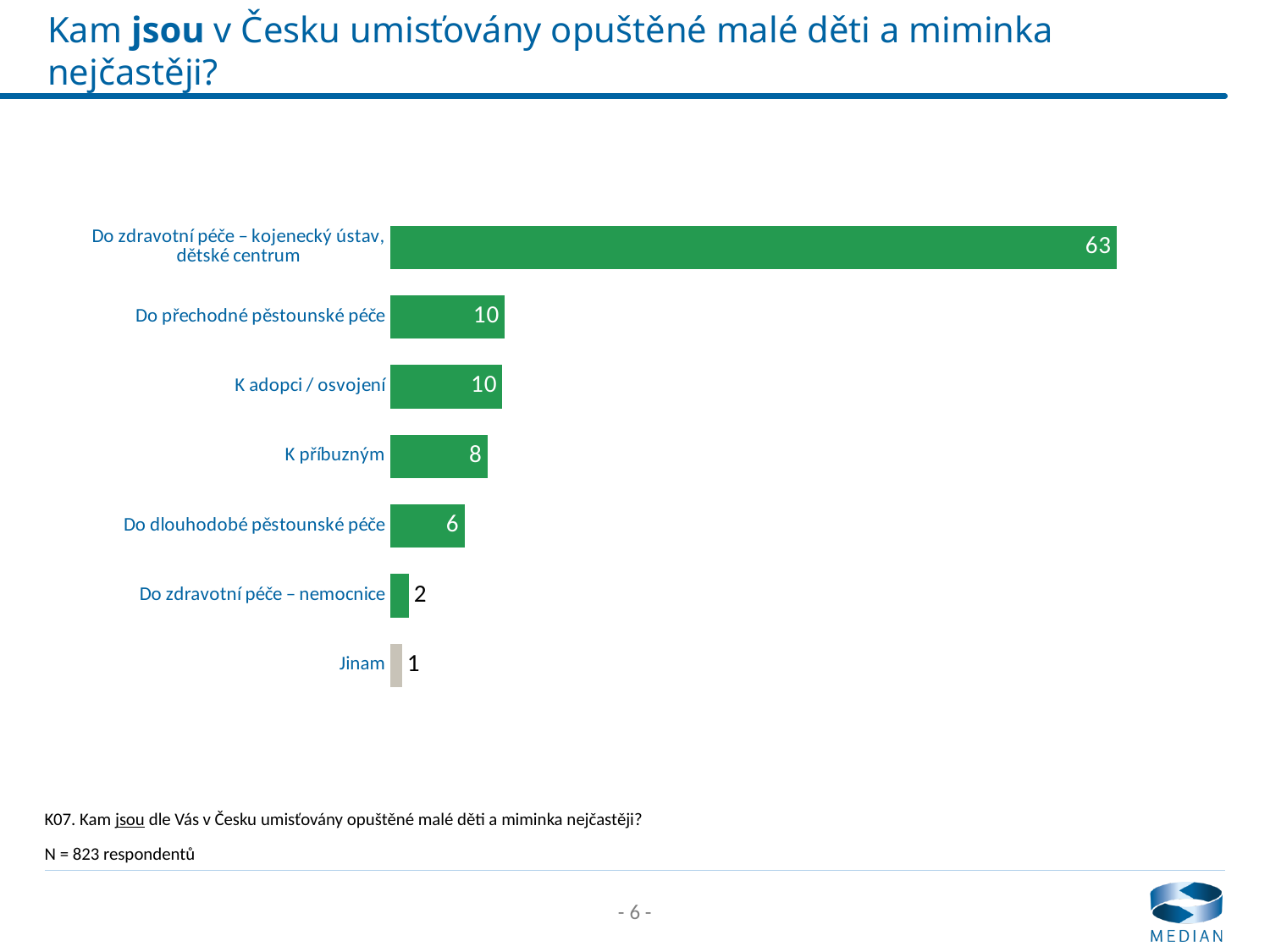
How many categories are shown in the chart? 7 What value is shown for "Do zdravotní péče – kojenecký ústav, dětské centrum"? 63 What value is shown for "Jinam"? 1 Which category has the highest value? Do zdravotní péče – kojenecký ústav, dětské centrum What is the difference between the values for "K příbuzným" and "Do zdravotní péče – nemocnice"? 6 Which category has the lowest value? Jinam What kind of chart is shown on the slide? Bar chart How many respondents does the note below the chart state? N = 823 respondentů What is the difference between the values for "Do zdravotní péče – kojenecký ústav, dětské centrum" and "Do přechodné pěstounské péče"? 53 What value is shown for "K příbuzným"? 8 Which is larger, the value for "K adopci / osvojení" or the value for "Do dlouhodobé pěstounské péče"? K adopci / osvojení What value is shown for "Do dlouhodobé pěstounské péče"? 6